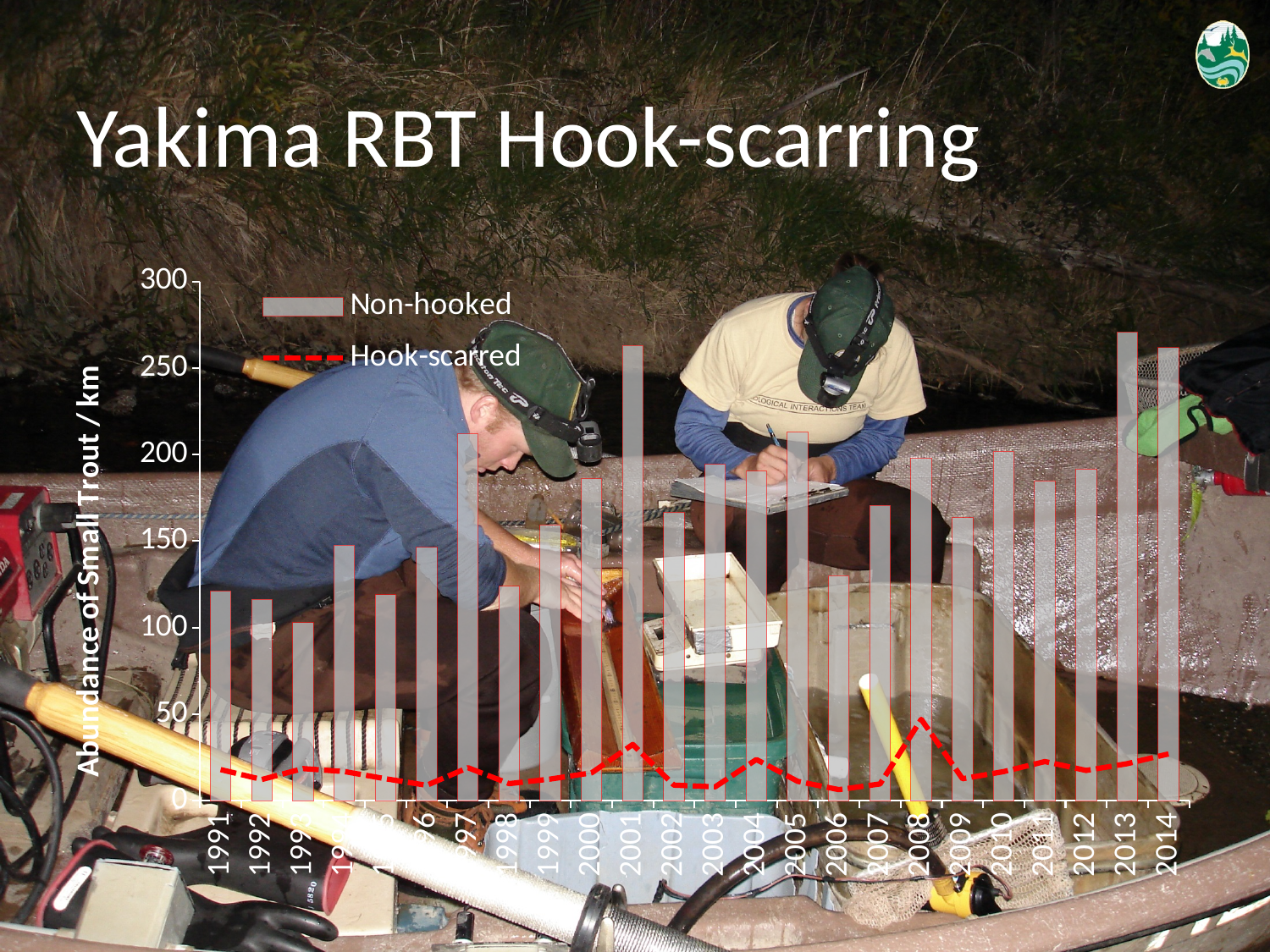
What is the title of the chart on the slide? Yakima RBT Hook-scarring Is the Non-hooked value for 2001 greater or less than 250? greater Is the Non-hooked value for 2006 greater or less than 150? less Which series is drawn as a red dashed line? Hook-scarred How many series does the legend list? 2 How many years are shown along the x axis? 24 Which year has the highest Hook-scarred value? 2008 Which is larger, the Non-hooked value for 2001 or for 1993? 2001 Is the Non-hooked value for 1993 greater or less than 150? less Does the Hook-scarred line rise or fall from 2008 to 2009? fall What is the label of the vertical axis? Abundance of Small Trout / km